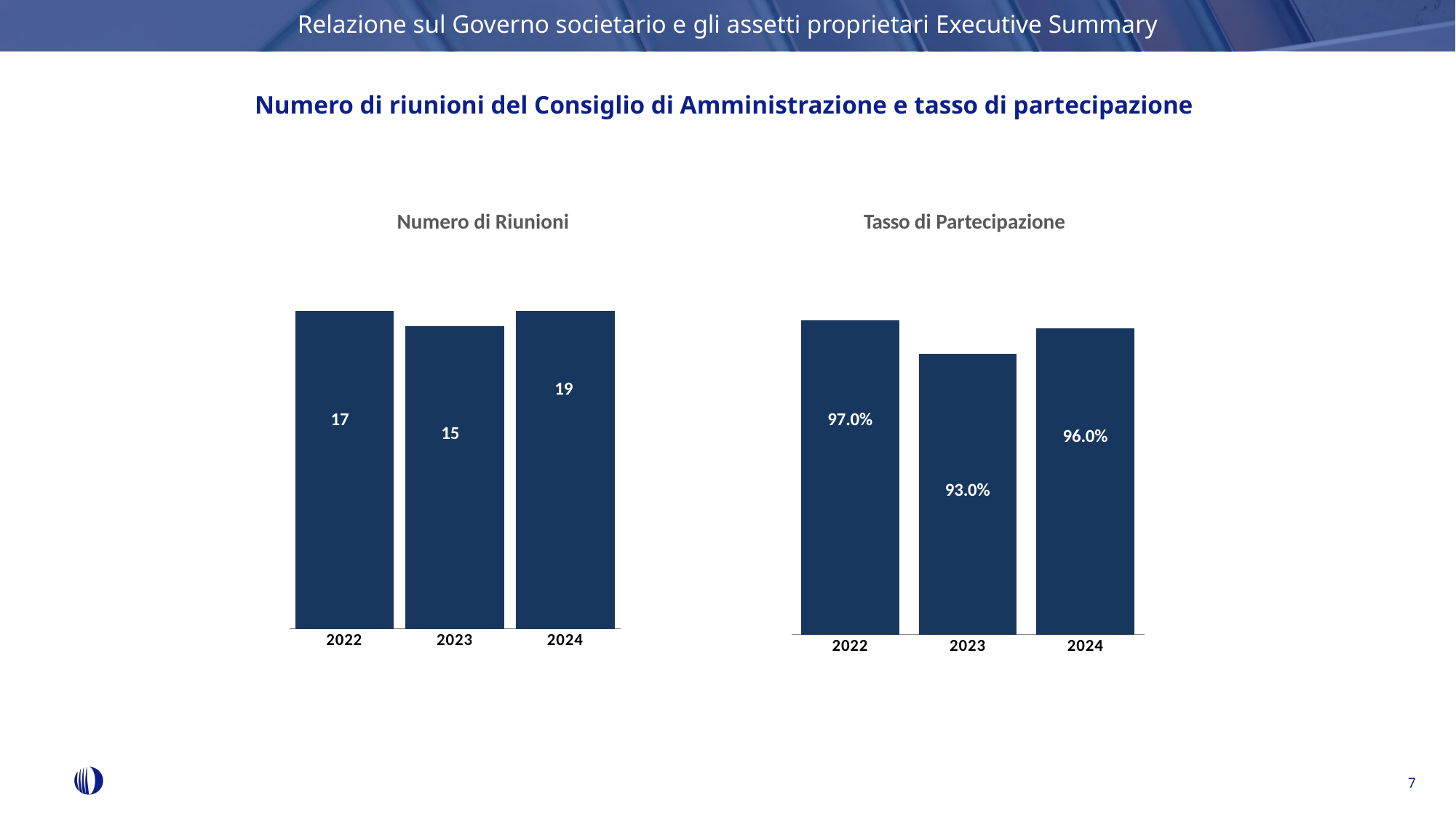
How many years are shown in the 'Tasso di Partecipazione' chart? 3 In the 'Numero di Riunioni' chart, which year has the highest value? 2024 In the 'Tasso di Partecipazione' chart, what is the difference between the values for 2022 and 2024? 1.0% In the 'Numero di Riunioni' chart, what is the value for 2024? 19 In the 'Tasso di Partecipazione' chart, which year has the lowest value? 2023 In the 'Numero di Riunioni' chart, what is the difference between the values for 2024 and 2023? 4 In the 'Tasso di Partecipazione' chart, what is the value for 2023? 93.0% In the 'Numero di Riunioni' chart, which is larger, the value for 2022 or the value for 2023? 2022 In the 'Numero di Riunioni' chart, what is the value for 2023? 15 What is the title of the chart on the right side of the slide? Tasso di Partecipazione What kind of chart is the 'Numero di Riunioni' chart? Bar chart In the 'Tasso di Partecipazione' chart, what is the value for 2022? 97.0%